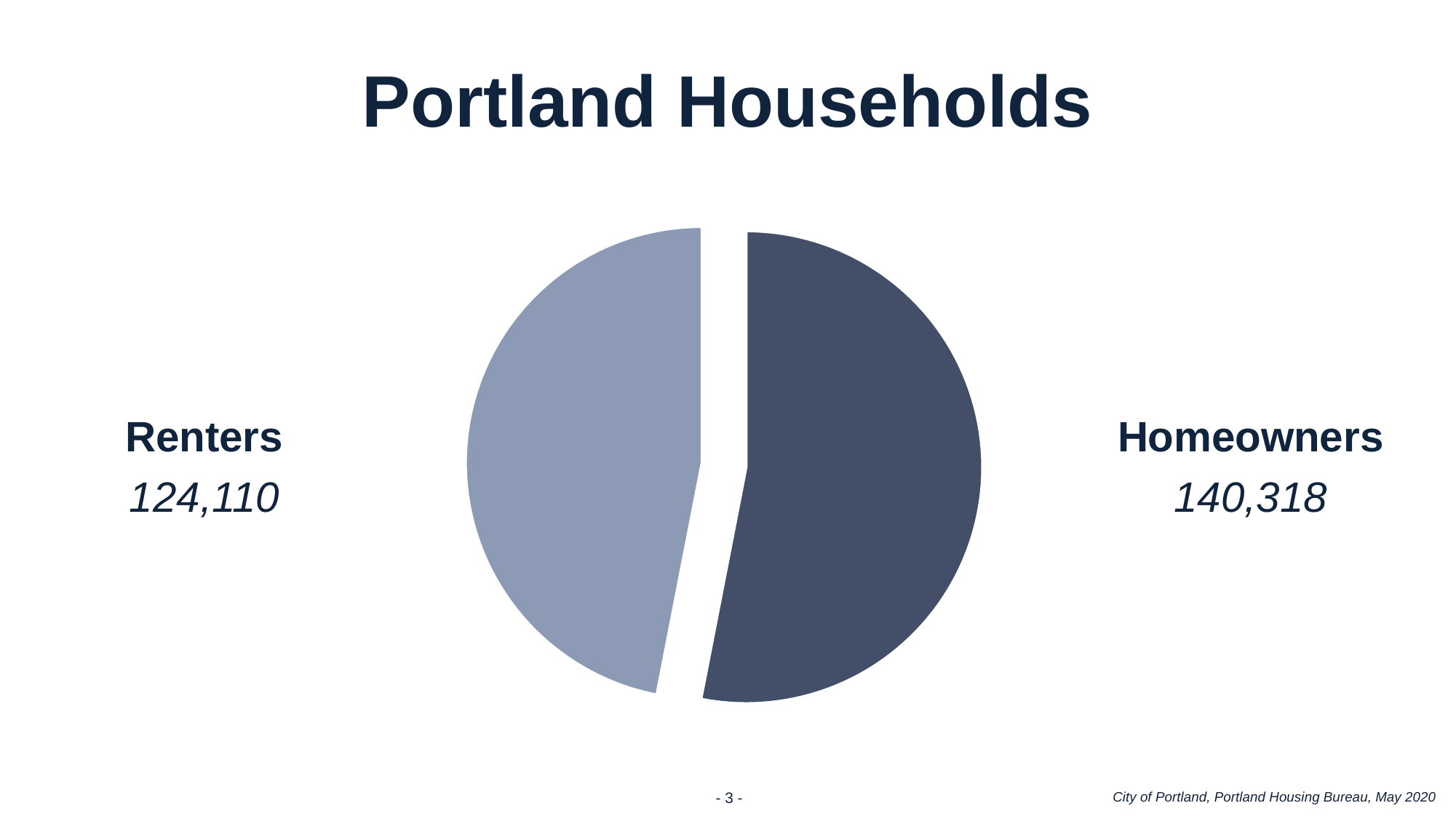
Which category has the largest value in the pie chart? Homeowners What is the value shown for Renters? 124,110 What is the value shown for Homeowners? 140,318 What is the difference between the Homeowners value and the Renters value? 16,208 What type of chart is shown on the slide? Pie chart Which slice is shown in the darker blue colour? Homeowners Which category has the larger value, Renters or Homeowners? Homeowners What is the total of the two values shown in the pie chart? 264,428 How many slices does the pie chart have? 2 What is the title of the chart? Portland Households Which category has the smallest value in the pie chart? Renters